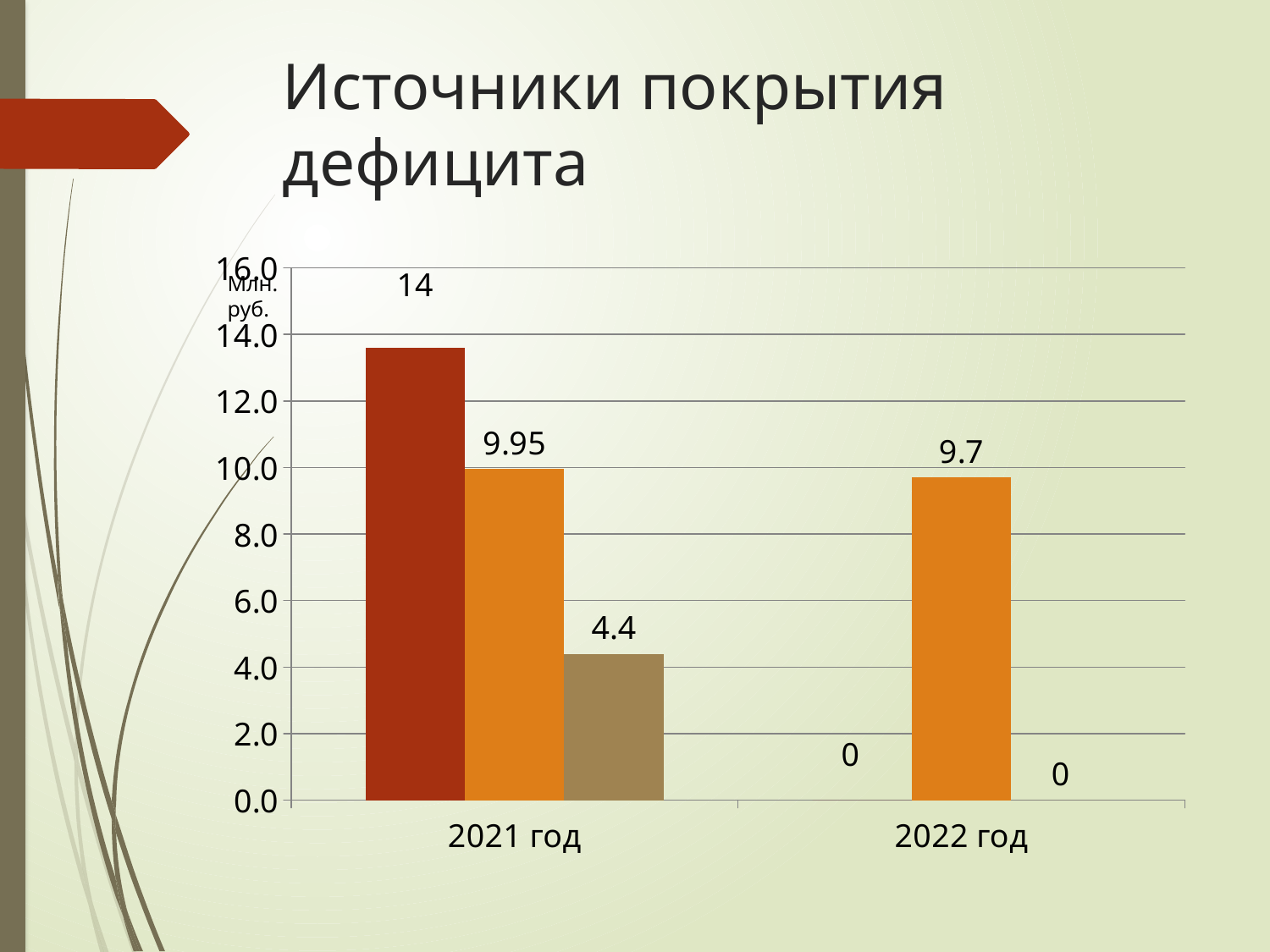
What is the value of the dark red bar for 2021 год? 14 What is the value of the orange bar for 2022 год? 9.7 What is the difference between the orange bar in 2021 год and the orange bar in 2022 год? 0.25 What kind of chart is shown on the slide? bar chart What is the value of the orange bar for 2021 год? 9.95 Is the orange bar larger in 2021 год or in 2022 год? 2021 год Which bar has the lowest value in 2021 год? the brown bar (4.4) What is the value of the brown bar for 2021 год? 4.4 What value is labelled for the dark red series in 2022 год? 0 How many year categories are shown on the x axis? 2 Which bar has the highest value in 2021 год? the dark red bar (14) What is the difference between the dark red bar and the orange bar in 2021 год? 4.05